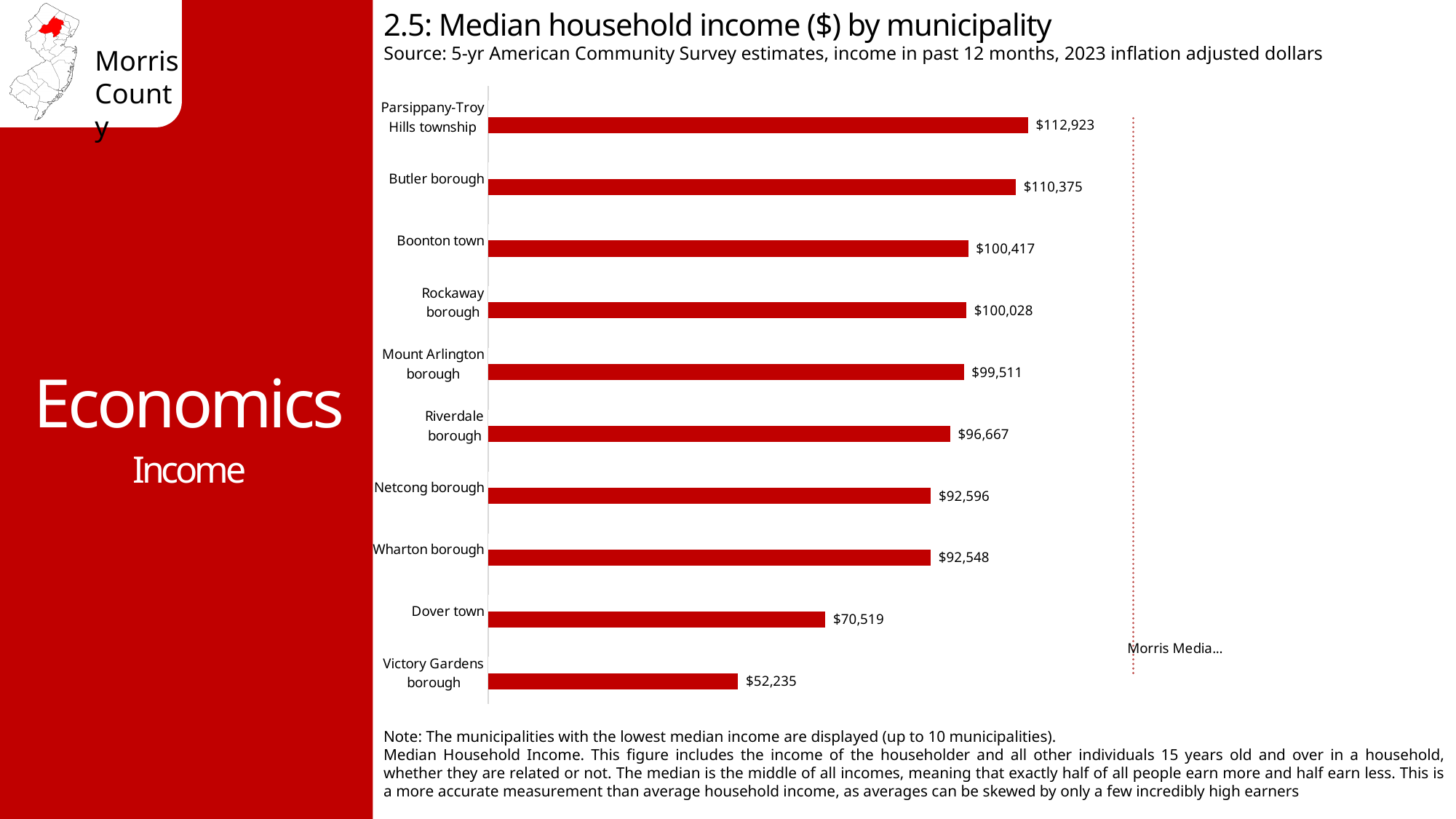
What is the difference in median household income between Dover town and Victory Gardens borough? $18,284 What is the median household income for Riverdale borough? $96,667 Which has a higher median household income, Netcong borough or Wharton borough? Netcong borough Which municipality has the lowest median household income shown on the chart? Victory Gardens borough What kind of chart is used on this slide? Bar chart What is the title of the chart? 2.5: Median household income ($) by municipality Which has a higher median household income, Mount Arlington borough or Rockaway borough? Rockaway borough How many municipalities are shown on the chart? 10 What is the median household income for Dover town? $70,519 What is the median household income for Parsippany-Troy Hills township? $112,923 Which municipality has the highest median household income shown on the chart? Parsippany-Troy Hills township What is the difference in median household income between Butler borough and Boonton town? $9,958